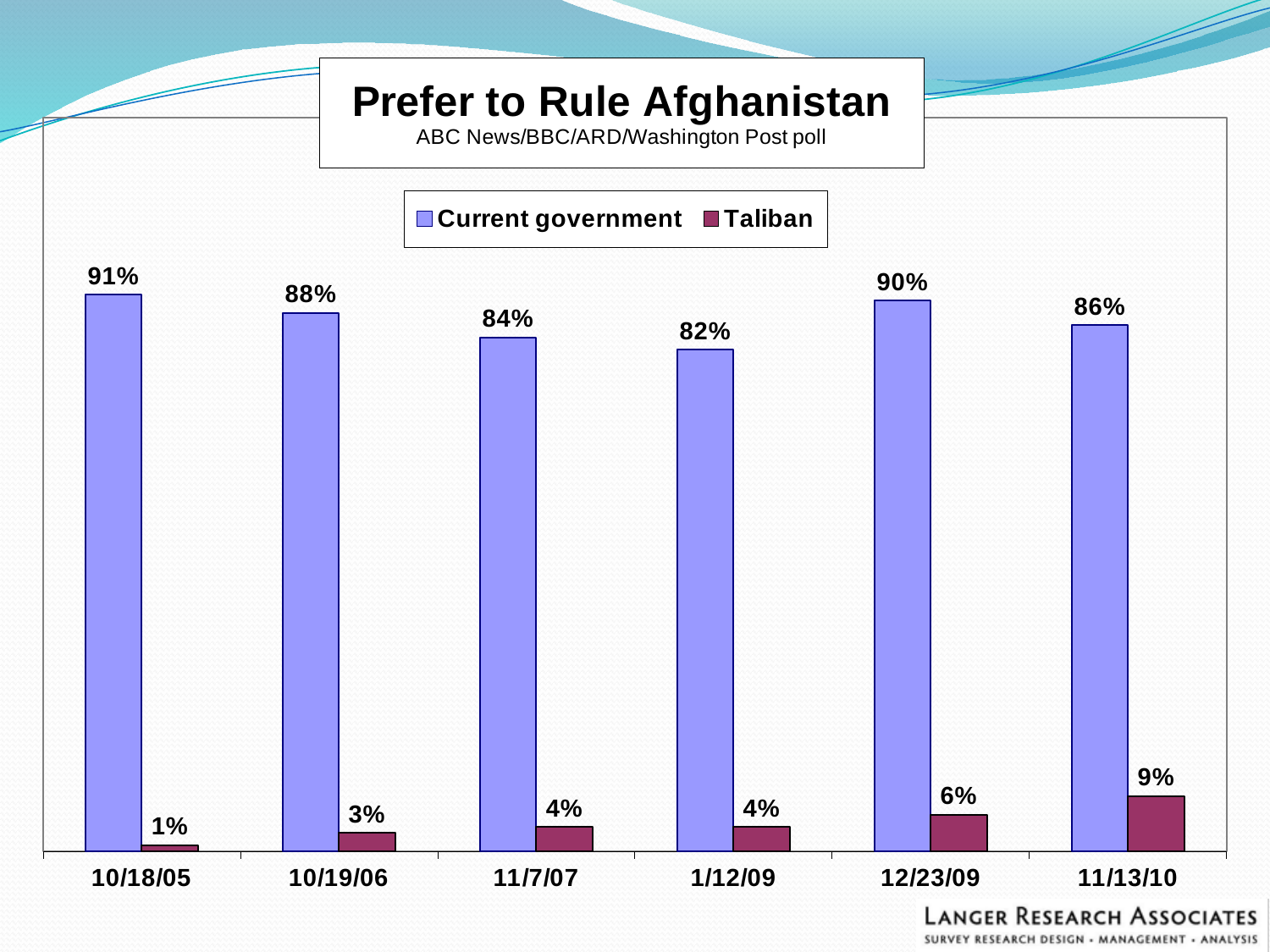
How many series does the legend list? 2 What kind of chart is shown on the slide? Bar chart Which is larger: the Current government value on 12/23/09 or on 11/13/10? 12/23/09 What is the difference between the Current government value on 10/18/05 and on 1/12/09? 9% What percentage preferred the Taliban in the 11/13/10 poll? 9% On which date was the Current government value lowest? 1/12/09 What percentage preferred the current government to rule Afghanistan in the 10/18/05 poll? 91% On which date was the Taliban value highest? 11/13/10 What was the Current government value on 1/12/09? 82% What is the difference between the Taliban value on 11/13/10 and on 10/18/05? 8% How many poll dates are shown on the x axis? 6 Which poll is cited in the chart's subtitle? ABC News/BBC/ARD/Washington Post poll